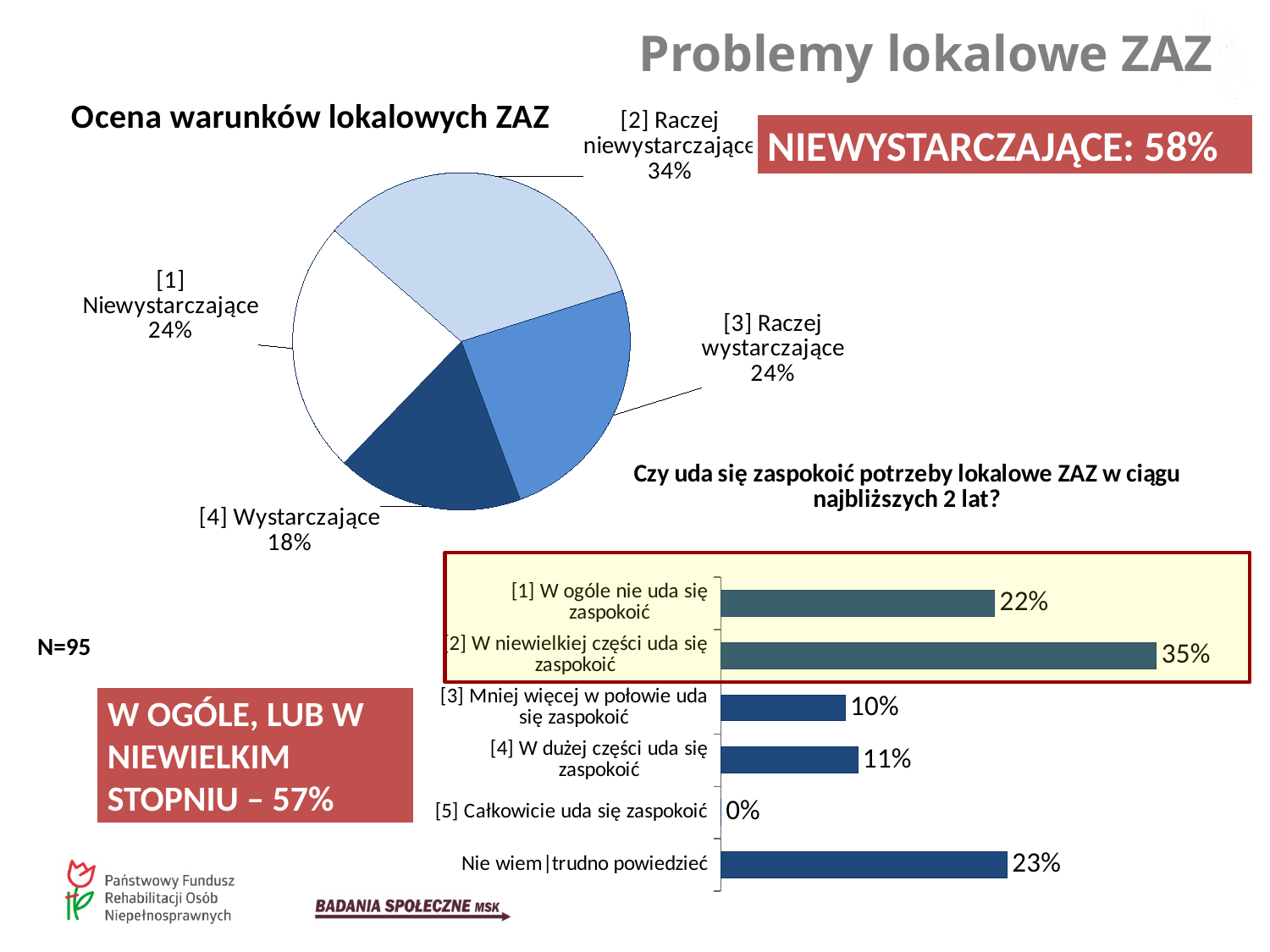
In the bar chart 'Czy uda się zaspokoić potrzeby lokalowe ZAZ w ciągu najbliższych 2 lat?', what is the value for 'Nie wiem|trudno powiedzieć'? 23% In the bar chart 'Czy uda się zaspokoić potrzeby lokalowe ZAZ w ciągu najbliższych 2 lat?', what is the value for '[2] W niewielkiej części uda się zaspokoić'? 35% In the bar chart 'Czy uda się zaspokoić potrzeby lokalowe ZAZ w ciągu najbliższych 2 lat?', how many categories are shown? 6 In the bar chart 'Czy uda się zaspokoić potrzeby lokalowe ZAZ w ciągu najbliższych 2 lat?', which is larger: '[3] Mniej więcej w połowie uda się zaspokoić' or '[4] W dużej części uda się zaspokoić'? [4] W dużej części uda się zaspokoić In the pie chart 'Ocena warunków lokalowych ZAZ', which category has the smallest share? [4] Wystarczające In the bar chart 'Czy uda się zaspokoić potrzeby lokalowe ZAZ w ciągu najbliższych 2 lat?', which category has the lowest value? [5] Całkowicie uda się zaspokoić In the pie chart 'Ocena warunków lokalowych ZAZ', what is the difference between '[2] Raczej niewystarczające' and '[4] Wystarczające'? 16% What type of chart is 'Ocena warunków lokalowych ZAZ'? Pie chart In the pie chart 'Ocena warunków lokalowych ZAZ', which category has the largest share? [2] Raczej niewystarczające In the pie chart 'Ocena warunków lokalowych ZAZ', what share is labelled '[2] Raczej niewystarczające'? 34% In the bar chart 'Czy uda się zaspokoić potrzeby lokalowe ZAZ w ciągu najbliższych 2 lat?', what is the difference between '[2] W niewielkiej części uda się zaspokoić' and '[1] W ogóle nie uda się zaspokoić'? 13% In the pie chart 'Ocena warunków lokalowych ZAZ', how many slices are there? 4